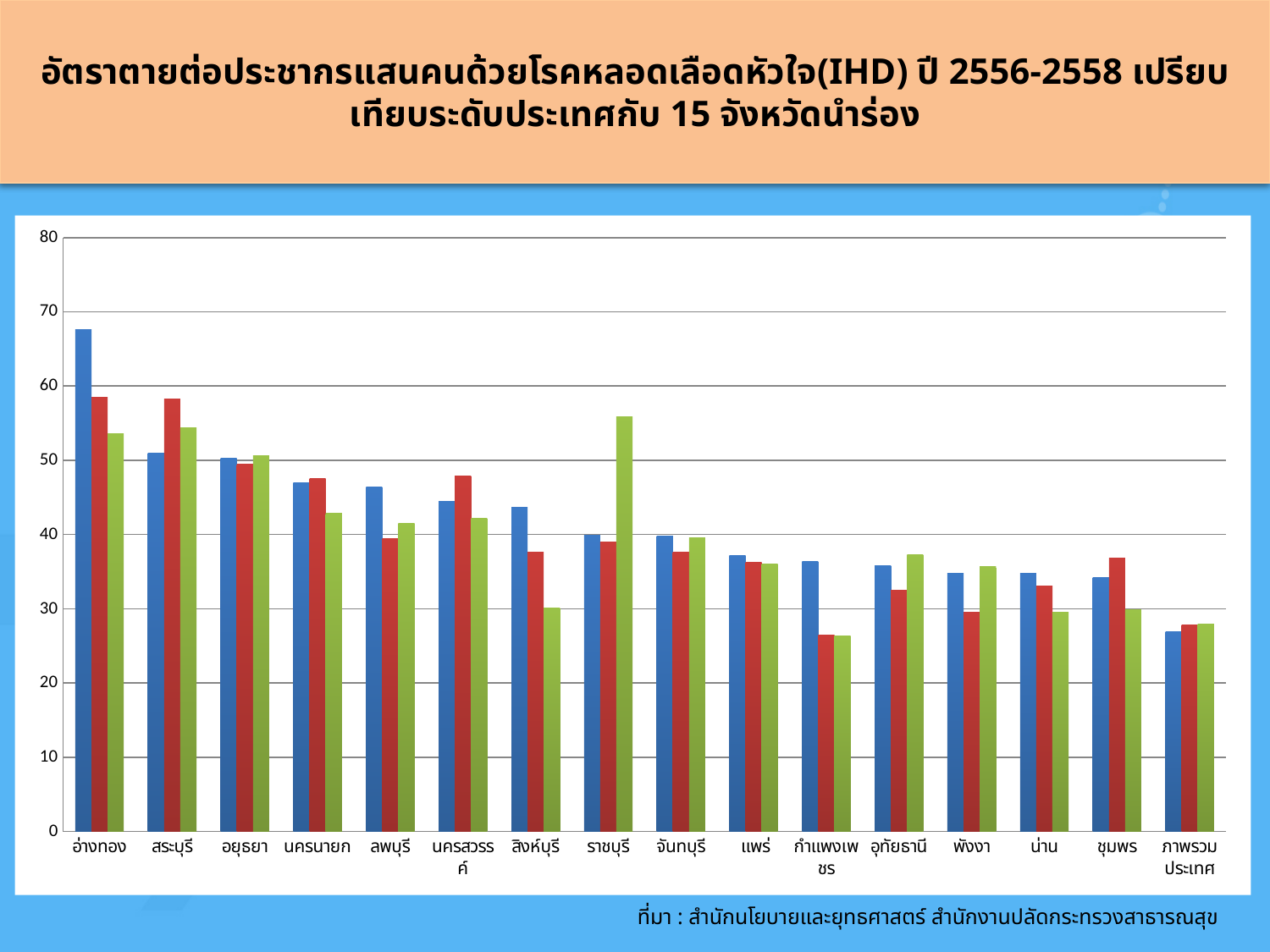
Which category has the tallest blue bar? อ่างทอง Is the value of the blue bar for อ่างทอง greater or less than 60? greater Which category has the shortest blue bar? ภาพรวมประเทศ Do the blue bars generally rise or fall from left to right across the categories? fall What is the highest value shown on the vertical axis of the chart? 80 How many bars are plotted for each category in the chart? 3 What kind of chart is shown on the slide? bar chart Is the value of the red bar for กำแพงเพชร greater or less than 30? less Is the value of the blue bar for ภาพรวมประเทศ greater or less than 30? less How many categories are shown along the x axis of the chart? 16 For สิงห์บุรี, which is larger: the blue bar or the green bar? the blue bar